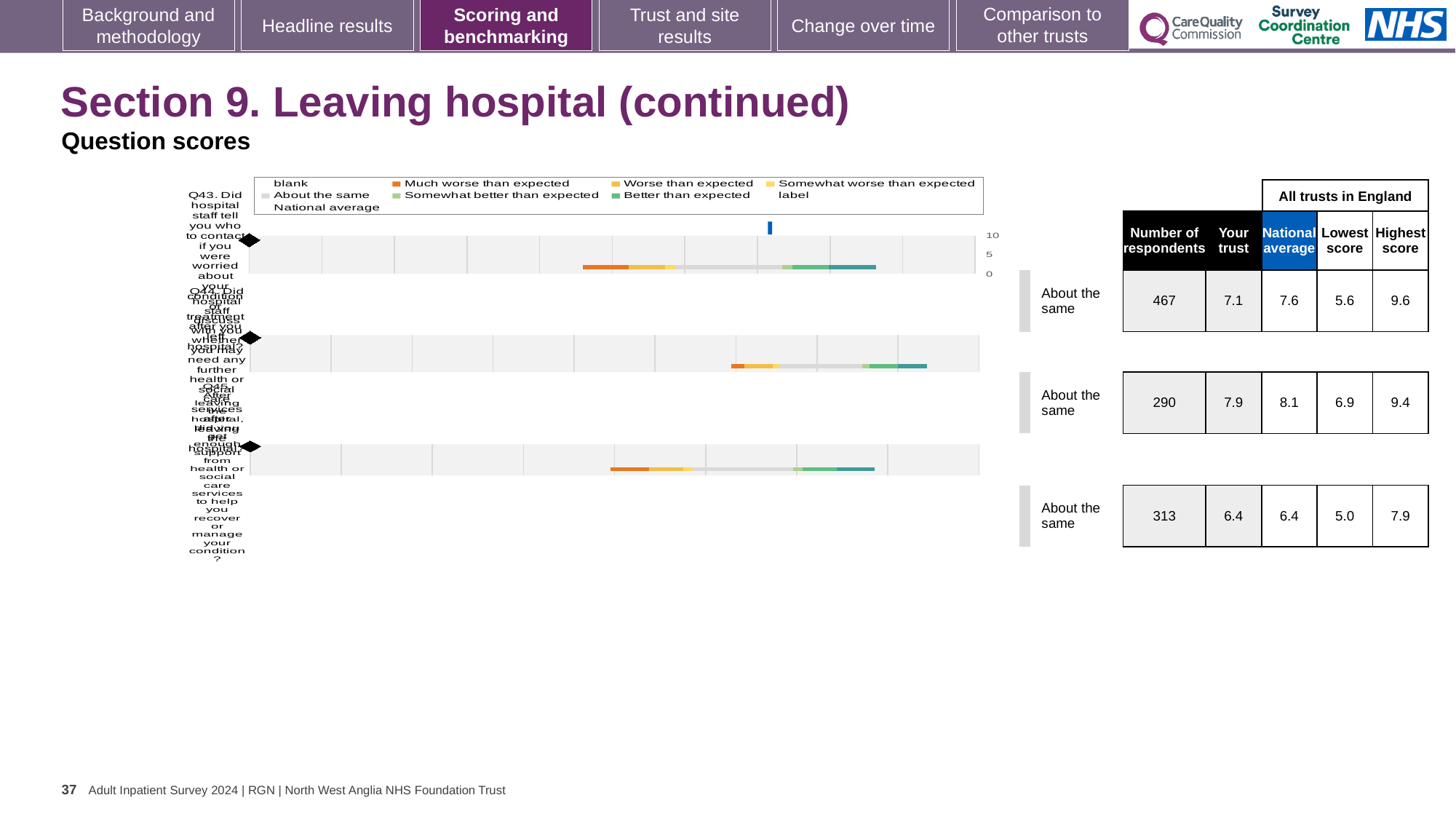
In the table beside the first chart (Q43), what is the national average score? 7.6 What benchmark label is shown next to each of the three charts? About the same What is the highest tick value shown on the chart axis? 10 In the table beside the first chart (Q43), what is the 'Your trust' score? 7.1 In the table beside the first chart (Q43), what is the number of respondents? 467 Which of the three chart rows has the highest 'Your trust' score in the table? the second row (7.9) In the table beside the third chart, what is the 'Your trust' score? 6.4 In the chart legend, what colour represents 'Much worse than expected'? orange For the first chart (Q43), which is larger: the 'Your trust' score or the national average? National average For the first chart (Q43), what is the difference between the highest score and the lowest score in the table? 4.0 How many question charts (rows of bars) are shown on the slide? 3 What kind of chart is used to show the question scores on this slide? bar chart